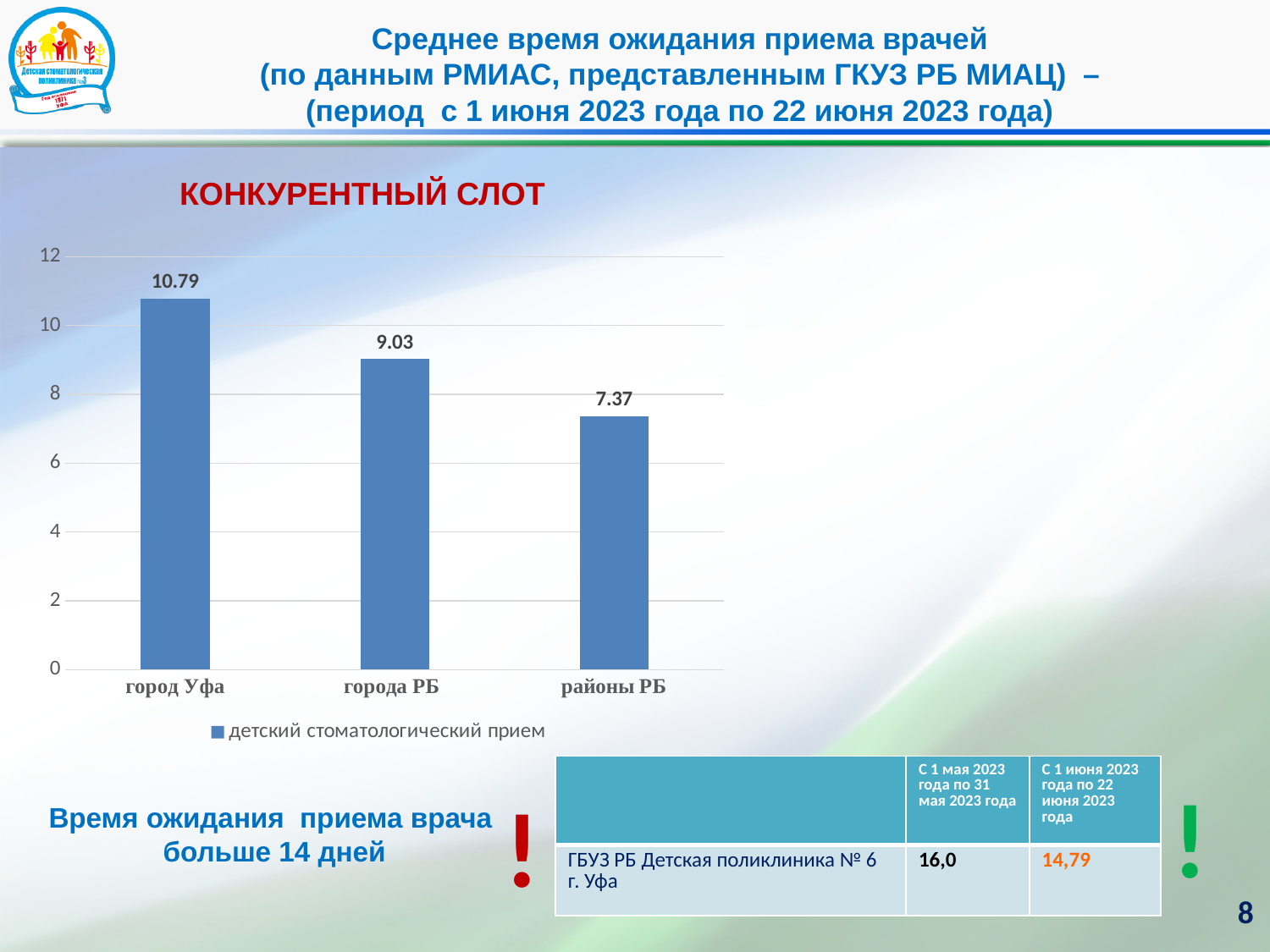
What kind of chart is shown on the slide? bar chart How many categories are shown on the x axis? 3 Which is larger, the value for города РБ or the value for районы РБ? города РБ What is the difference between the values for город Уфа and города РБ? 1.76 What is the value for районы РБ? 7.37 Which category has the lowest value? районы РБ Do the values rise or fall from left to right along the x axis? fall What is the difference between the values for город Уфа and районы РБ? 3.42 What is the value for город Уфа? 10.79 What is the value for города РБ? 9.03 Which category has the highest value? город Уфа Is the value for город Уфа greater or less than 10? greater